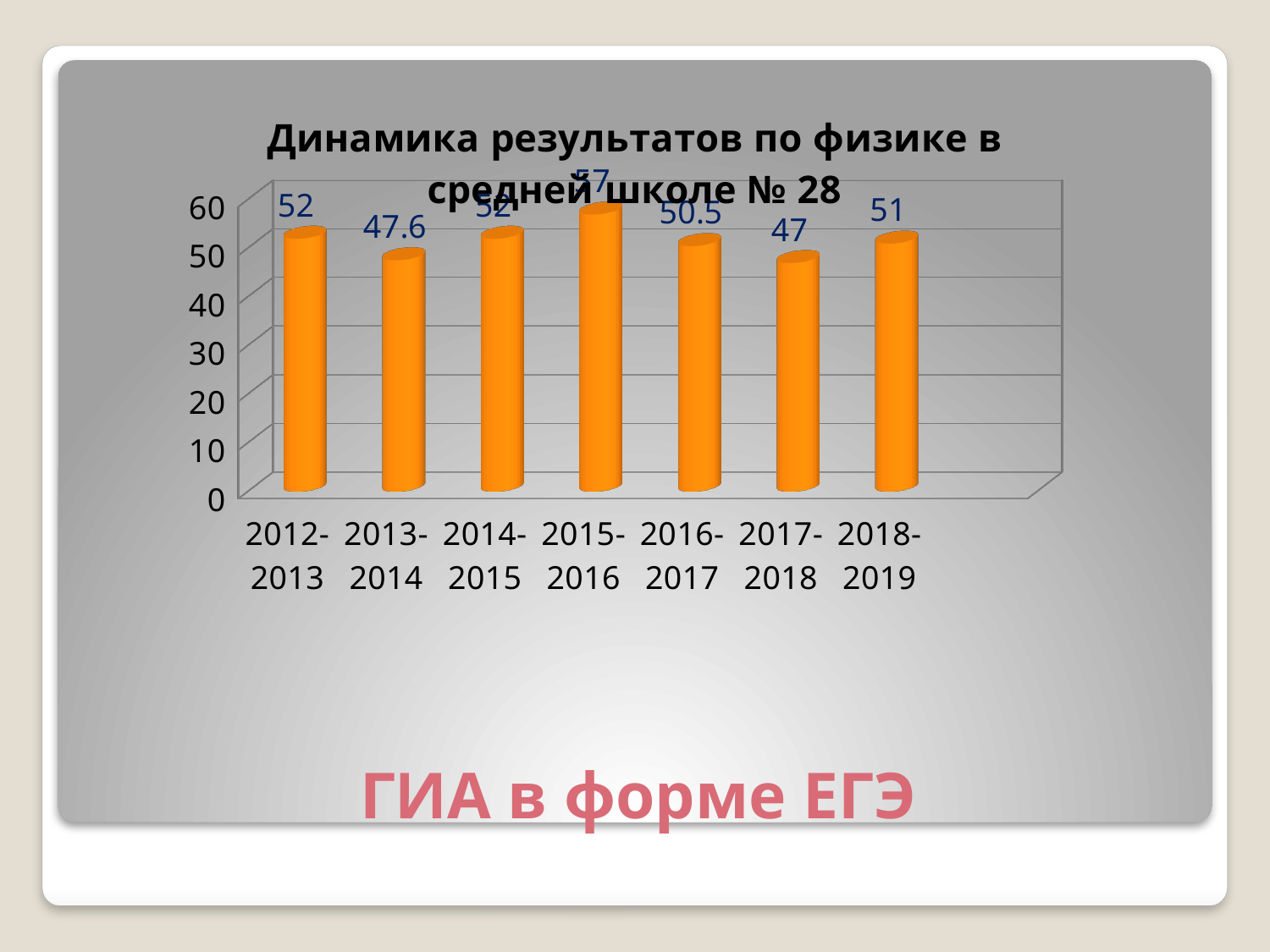
Which academic year has the lowest value? 2017-2018 What is the value for 2018-2019? 51 What is the value for 2012-2013? 52 What is the value for 2017-2018? 47 Which academic year has the highest value? 2015-2016 What is the title of the chart? Динамика результатов по физике в средней школе № 28 What is the difference between the values for 2015-2016 and 2017-2018? 10 What kind of chart is shown on the slide? Bar chart What is the value for 2013-2014? 47.6 Which is larger, the value for 2016-2017 or the value for 2018-2019? 2018-2019 What is the value for 2016-2017? 50.5 How many academic years are shown on the chart? 7